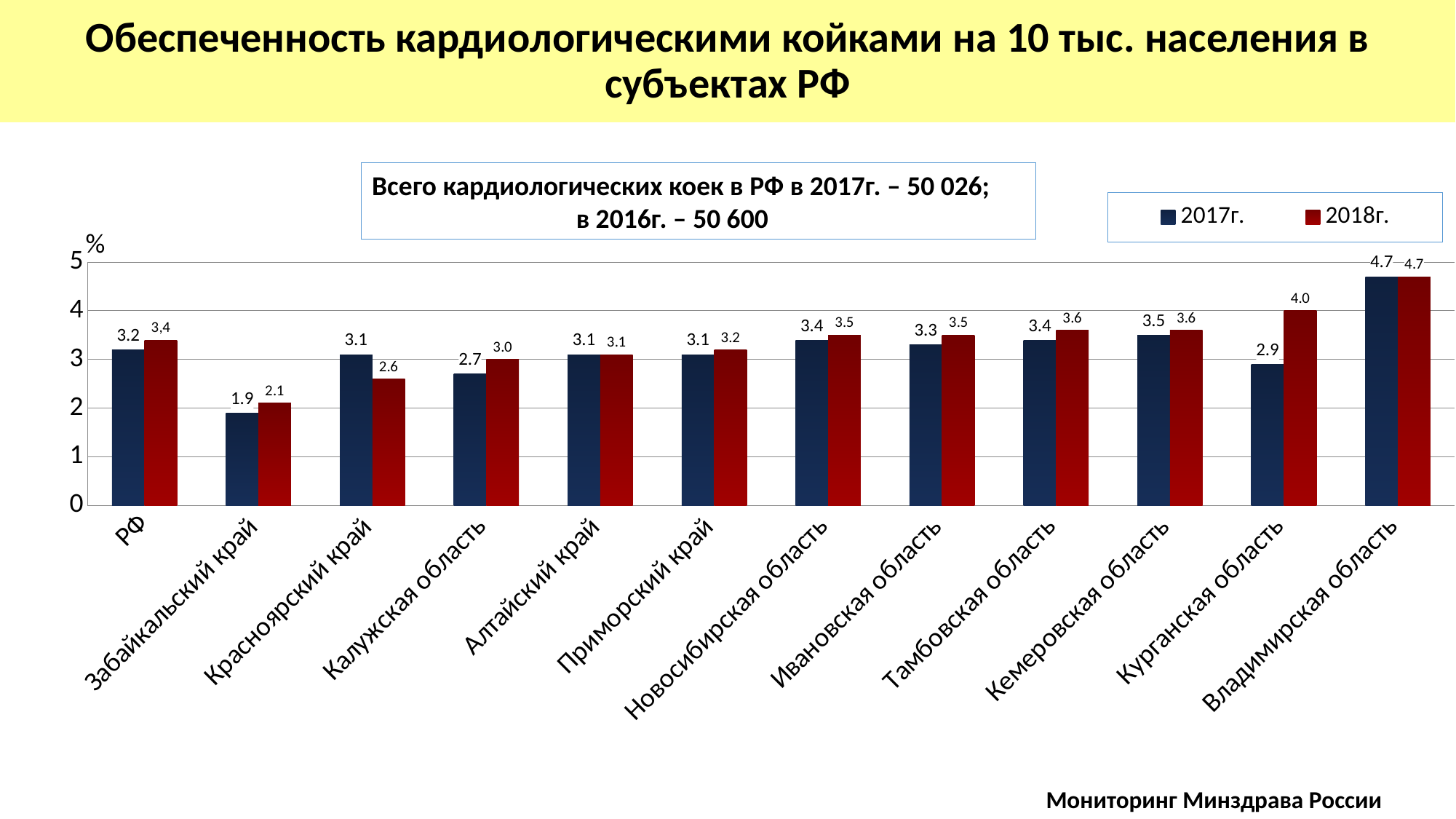
What is the value for Курганская область in 2018г.? 4.0 What is the value for РФ in 2018г.? 3,4 Which category has the highest value in 2017г.? Владимирская область How many categories are shown on the x axis? 12 What is the value for Забайкальский край in 2017г.? 1.9 What kind of chart is shown on the slide? bar chart What is the difference between the 2018г. and 2017г. values for Курганская область? 1.1 Is the value for Владимирская область in 2017г. greater or less than 4? greater Which category has the lowest value in 2018г.? Забайкальский край Which is larger for Красноярский край: the 2017г. value or the 2018г. value? 2017г. What is the value for Красноярский край in 2018г.? 2.6 How many series does the legend list? 2